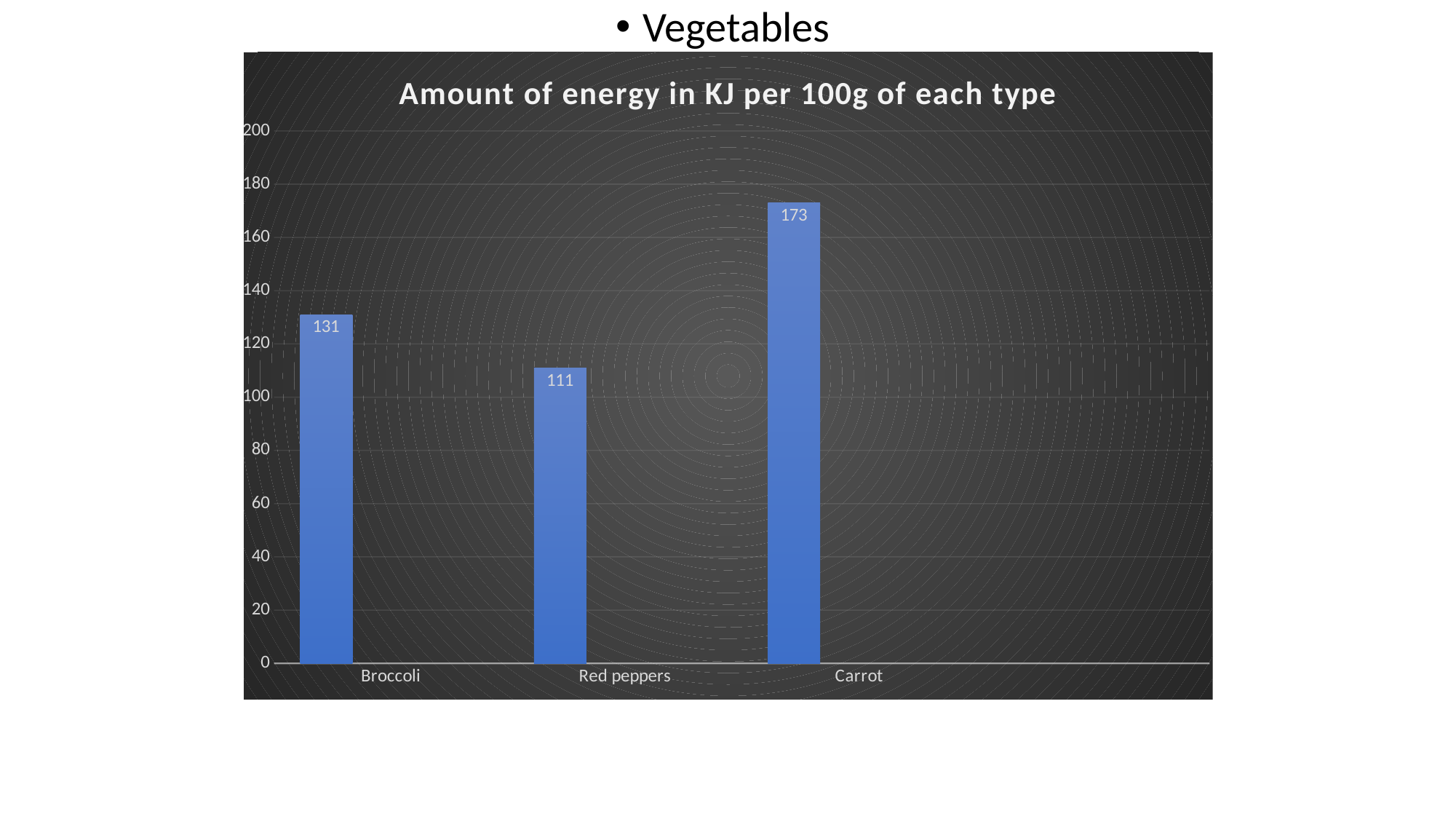
How many vegetables are shown on the chart? 3 Is the value for Carrot greater or less than 160? greater What is the difference between the values for Broccoli and Red peppers? 20 What is the value for Broccoli? 131 What is the value for Carrot? 173 Which vegetable has the highest amount of energy? Carrot What is the title of the chart? Amount of energy in KJ per 100g of each type What is the difference between the values for Carrot and Broccoli? 42 What is the value for Red peppers? 111 What kind of chart is shown on the slide? Bar chart Which vegetable has the lowest amount of energy? Red peppers Which is larger, the value for Broccoli or the value for Red peppers? Broccoli